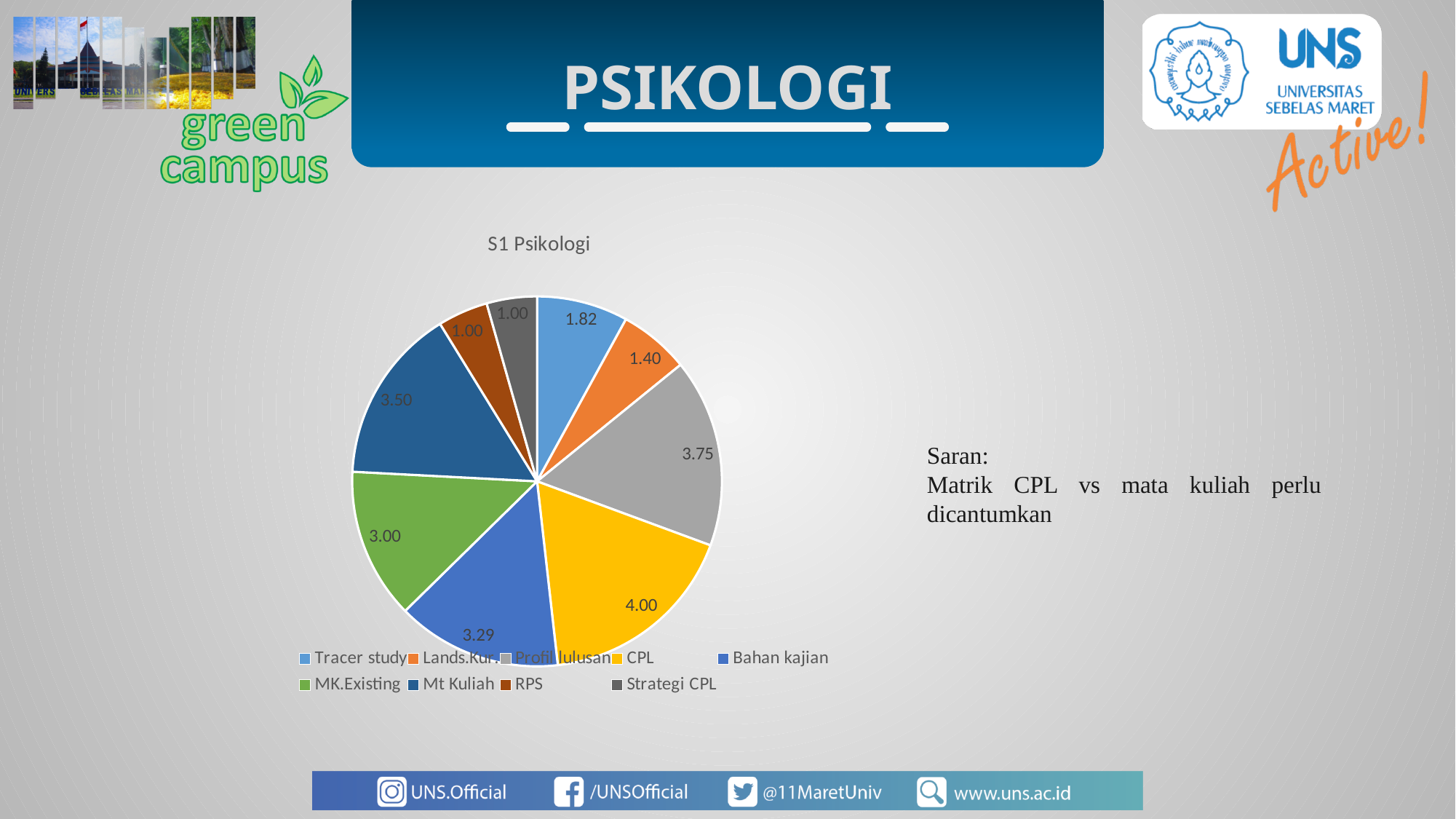
What is the difference between the values for CPL and Profil lulusan? 0.25 Which is larger, the value for Bahan kajian or the value for MK.Existing? Bahan kajian What is the value for CPL in the pie chart? 4.00 What is the value for Tracer study in the pie chart? 1.82 Which category has the largest slice in the pie chart? CPL What is the difference between the values for Mt Kuliah and RPS? 2.50 How many categories does the pie chart have? 9 What is the value for Lands.Kur. in the pie chart? 1.40 What type of chart is shown on the slide? Pie chart Which colour represents Profil lulusan in the pie chart? Gray What is the value for Mt Kuliah in the pie chart? 3.50 What is the title of the chart? S1 Psikologi